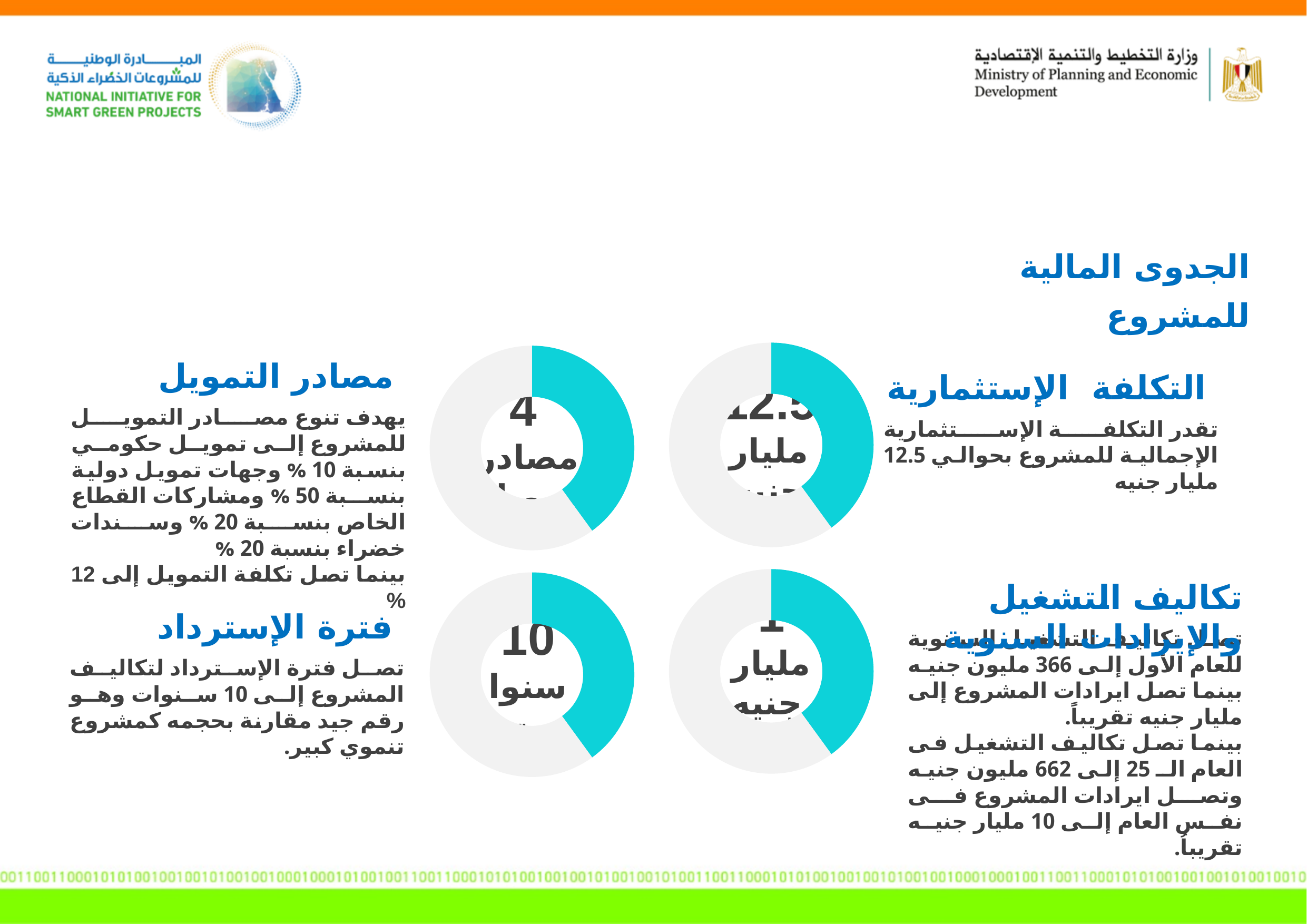
How many donut charts are on the slide? 4 In the top-right donut chart, which slice is larger, the teal one or the grey one? grey What number is printed in the centre of the top-left donut chart (next to مصادر التمويل)? 4 What two colours are used for the slices of the donut charts? Teal and light grey In the top-left donut chart, which slice is larger, the teal one or the grey one? grey What number is printed in the centre of the bottom-left donut chart (next to فترة الإسترداد)? 10 What kind of charts are shown in the middle of the slide? Donut (pie) charts How many slices does each donut chart have? 2 In the bottom-right donut chart, which slice is smaller, the teal one or the grey one? teal What unit word appears under the number in the bottom-left donut chart? سنوات